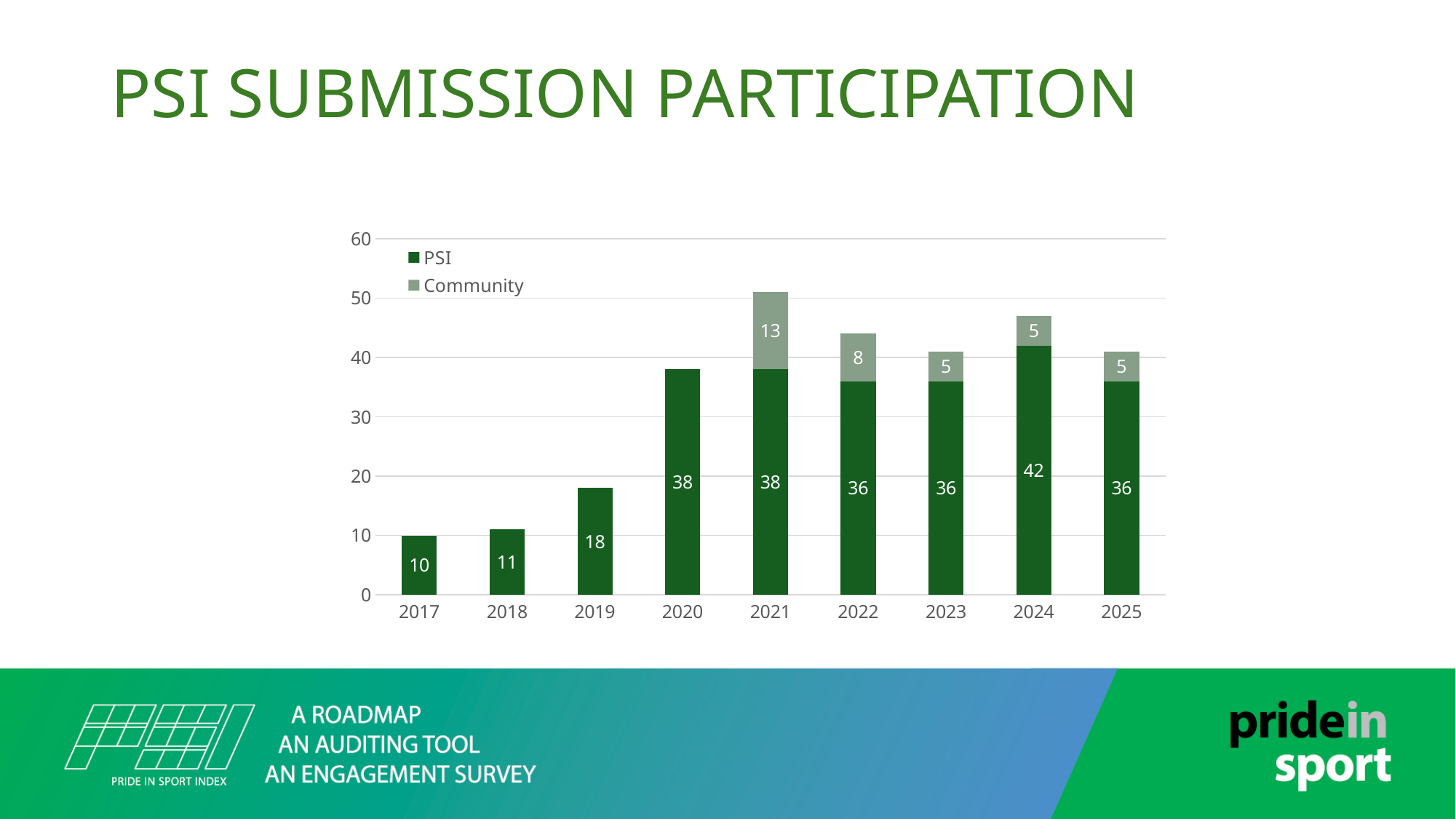
How many years are shown on the x axis? 9 Which year has the lowest PSI value? 2017 What is the PSI value for 2020? 38 Which year has the highest PSI value? 2024 What is the PSI value for 2017? 10 What is the difference between the PSI values for 2019 and 2018? 7 Which is larger, the Community value for 2022 or the Community value for 2023? 2022 What is the Community value for 2021? 13 How many series does the legend list? 2 What is the total of the stacked bar for 2024? 47 What is the total of the stacked bar for 2021? 51 What kind of chart is shown on the slide? Stacked bar chart